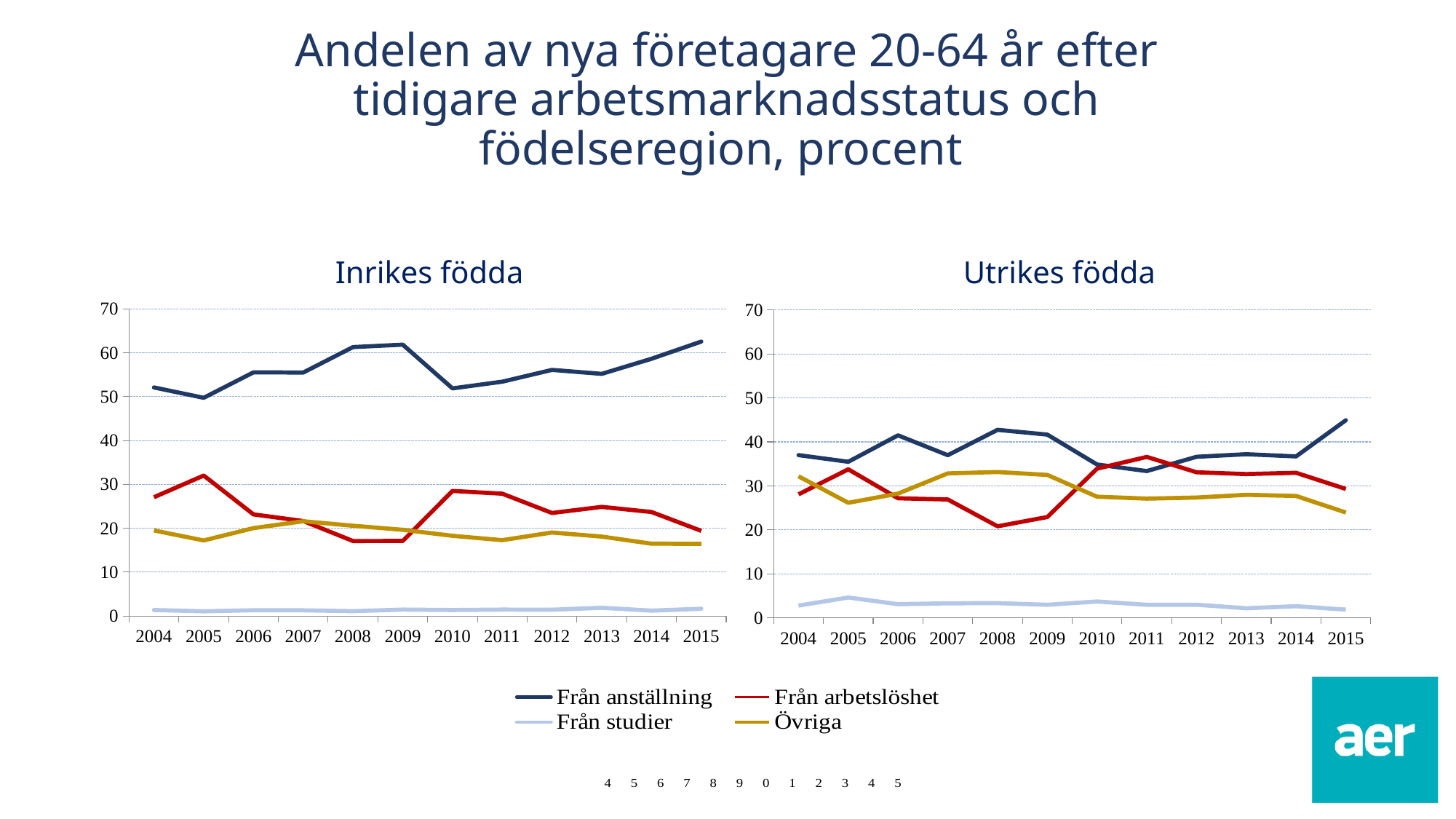
In the 'Utrikes födda' chart, does 'Från anställning' rise or fall from 2014 to 2015? rise What kind of chart is the 'Inrikes födda' chart? line chart How many series does the legend list? 4 In the 'Utrikes födda' chart, which is larger in 2004: 'Övriga' or 'Från arbetslöshet'? Övriga In the 'Utrikes födda' chart, which series has the highest value in 2008? Från anställning In the 'Inrikes födda' chart, is the value for 'Från anställning' in 2015 greater or less than 60? greater How many years are shown on the x axis of the 'Utrikes födda' chart? 12 In the 'Utrikes födda' chart, is the value for 'Från anställning' in 2011 greater or less than 40? less In the 'Inrikes födda' chart, which series has the lowest values across all years? Från studier What colour is the 'Från arbetslöshet' line in the legend? red In the 'Inrikes födda' chart, is the value for 'Från arbetslöshet' in 2005 greater or less than 30? greater